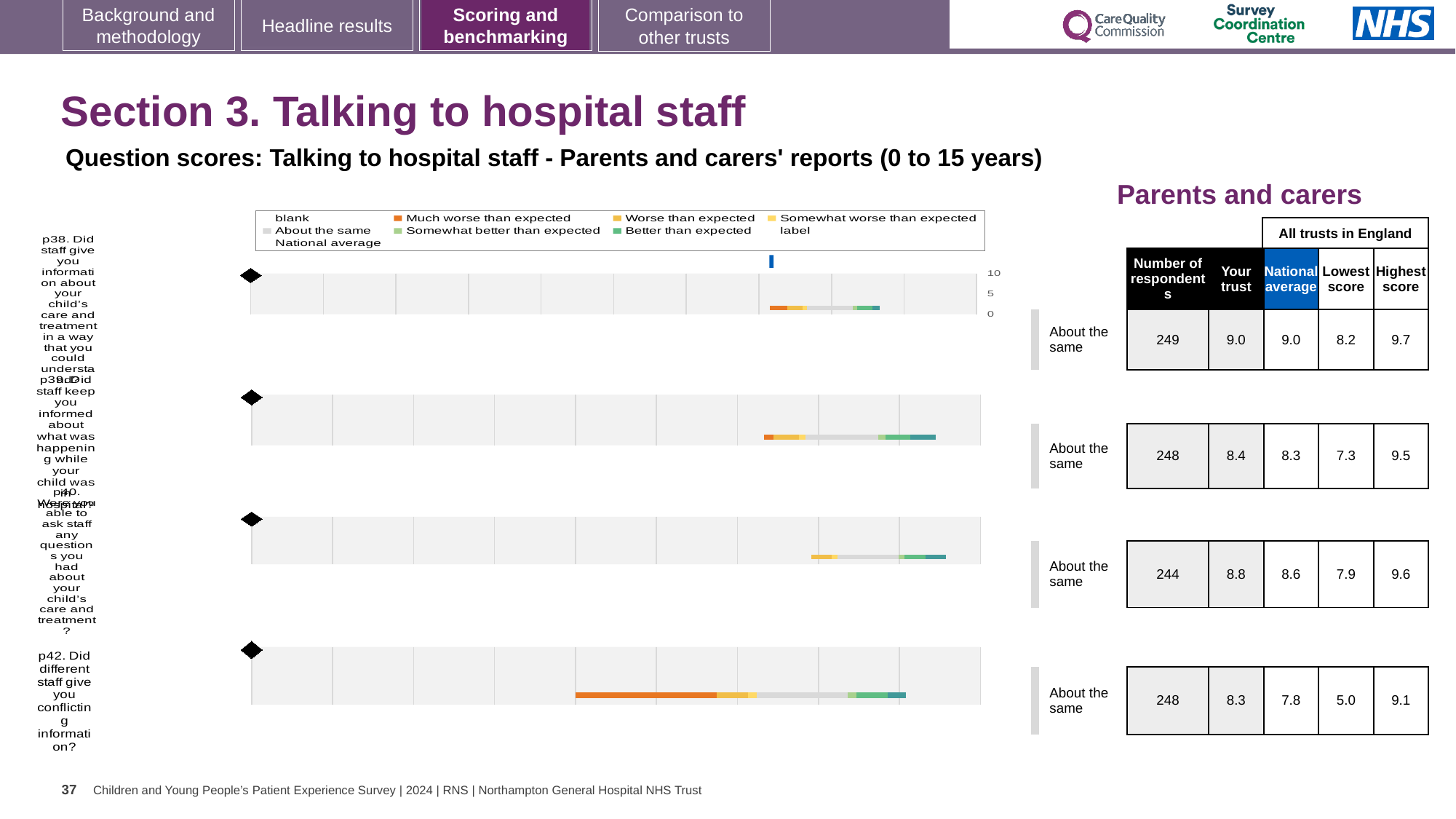
For the p39 chart (staff keeping you informed), what is the highest score across all trusts in England? 9.5 For the p40 chart (able to ask staff any questions), how many respondents are listed? 244 In the legend, what colour represents 'Much worse than expected'? orange Which question chart has the highest 'Your trust' score? p38 How many question charts (p38, p39, p40, p42) are shown on the slide? 4 For the p38 chart (staff giving information about your child's care and treatment), what is the 'Your trust' score shown in the table? 9.0 For the p42 chart, which is larger: the 'Your trust' score or the national average? Your trust For the p40 chart, what is the difference between the 'Your trust' score and the national average? 0.2 What benchmark label is shown next to the p42 chart? About the same Which question chart has the lowest 'Your trust' score? p42 What kind of chart is used for the question scores on this slide? bar chart For the p42 chart (different staff giving conflicting information), what is the lowest score across all trusts in England? 5.0